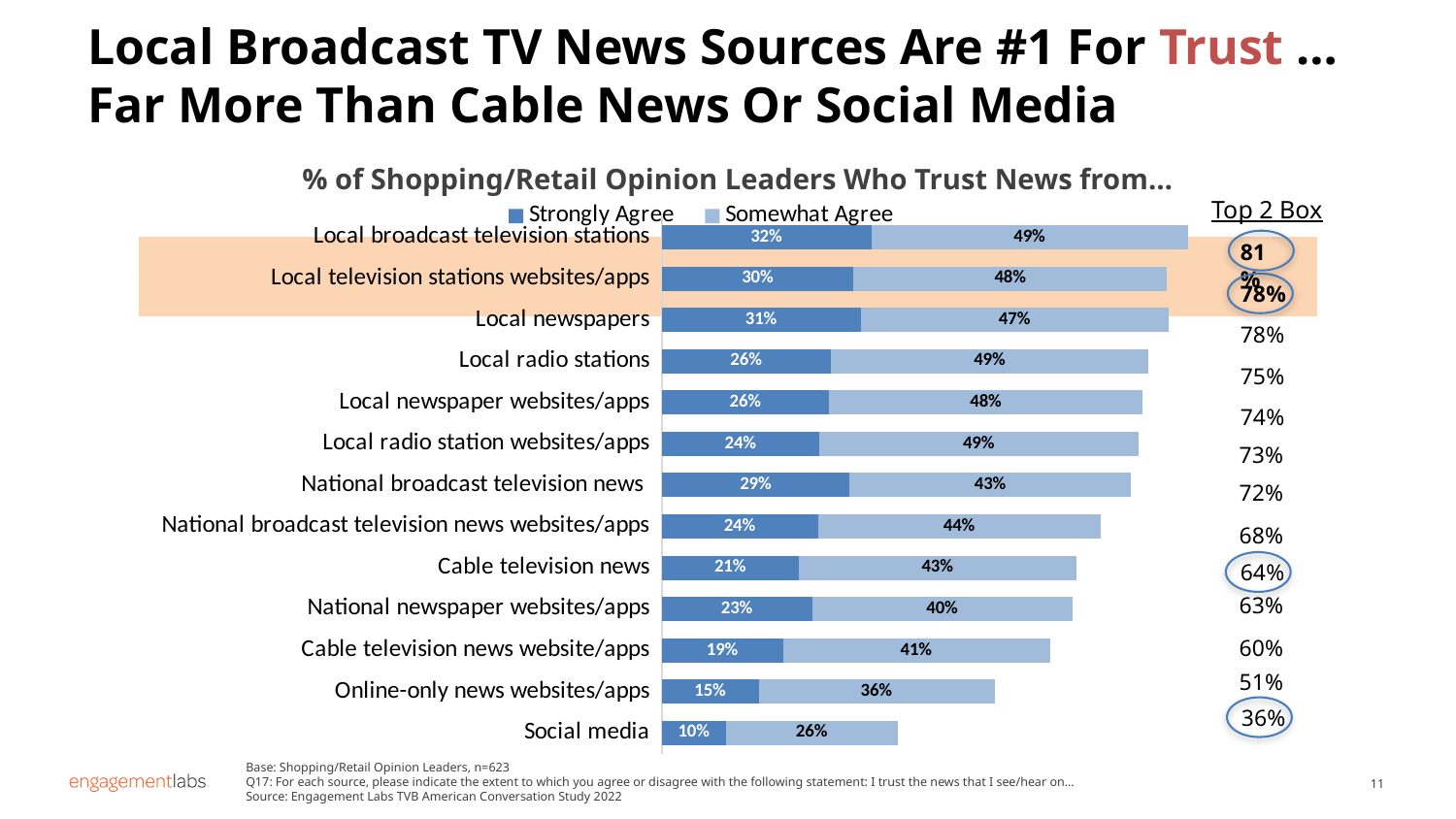
What type of chart is shown on the slide? Stacked bar chart Which news source has the lowest Strongly Agree percentage? Social media What is the Strongly Agree value for Cable television news? 21% What is the difference between the Somewhat Agree values for Local radio stations and Cable television news? 6% Which news source has the highest Strongly Agree percentage? Local broadcast television stations Which is larger: the Strongly Agree value for National broadcast television news or for National newspaper websites/apps? National broadcast television news How many series does the legend list? 2 What is the Top 2 Box value shown for Social media? 36% What is the total (Strongly Agree plus Somewhat Agree) for Online-only news websites/apps? 51% How many news sources are shown in the chart? 13 What percentage of Shopping/Retail Opinion Leaders strongly agree that they trust news from Local broadcast television stations? 32% What is the Somewhat Agree value for Social media? 26%